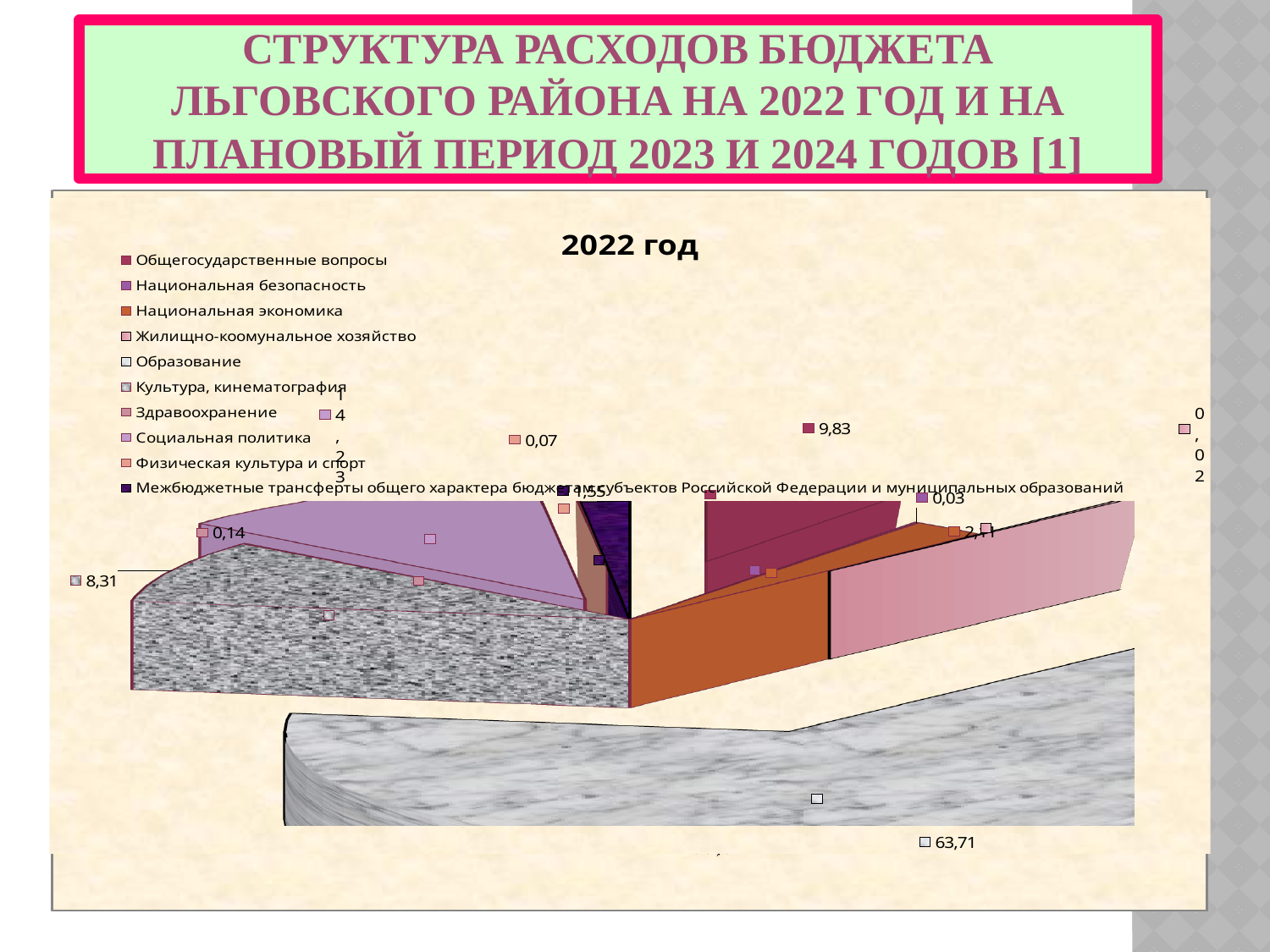
What is the smallest value labelled on the chart? 0,02 What is the difference between the value for Образование and the value for Общегосударственные вопросы? 53,88 What is the largest value labelled on the chart? 63,71 What is the value labelled for Общегосударственные вопросы? 9,83 What kind of chart is shown on the slide? pie chart How many entries does the chart legend list? 10 Which category has the largest share of the pie? Образование What is the value labelled for Образование? 63,71 Which legend entry is listed first in the chart legend? Общегосударственные вопросы What is the title of the chart? 2022 год What is the value labelled for Национальная экономика? 2,11 Which is larger: the value for Общегосударственные вопросы or the value for Национальная экономика? Общегосударственные вопросы